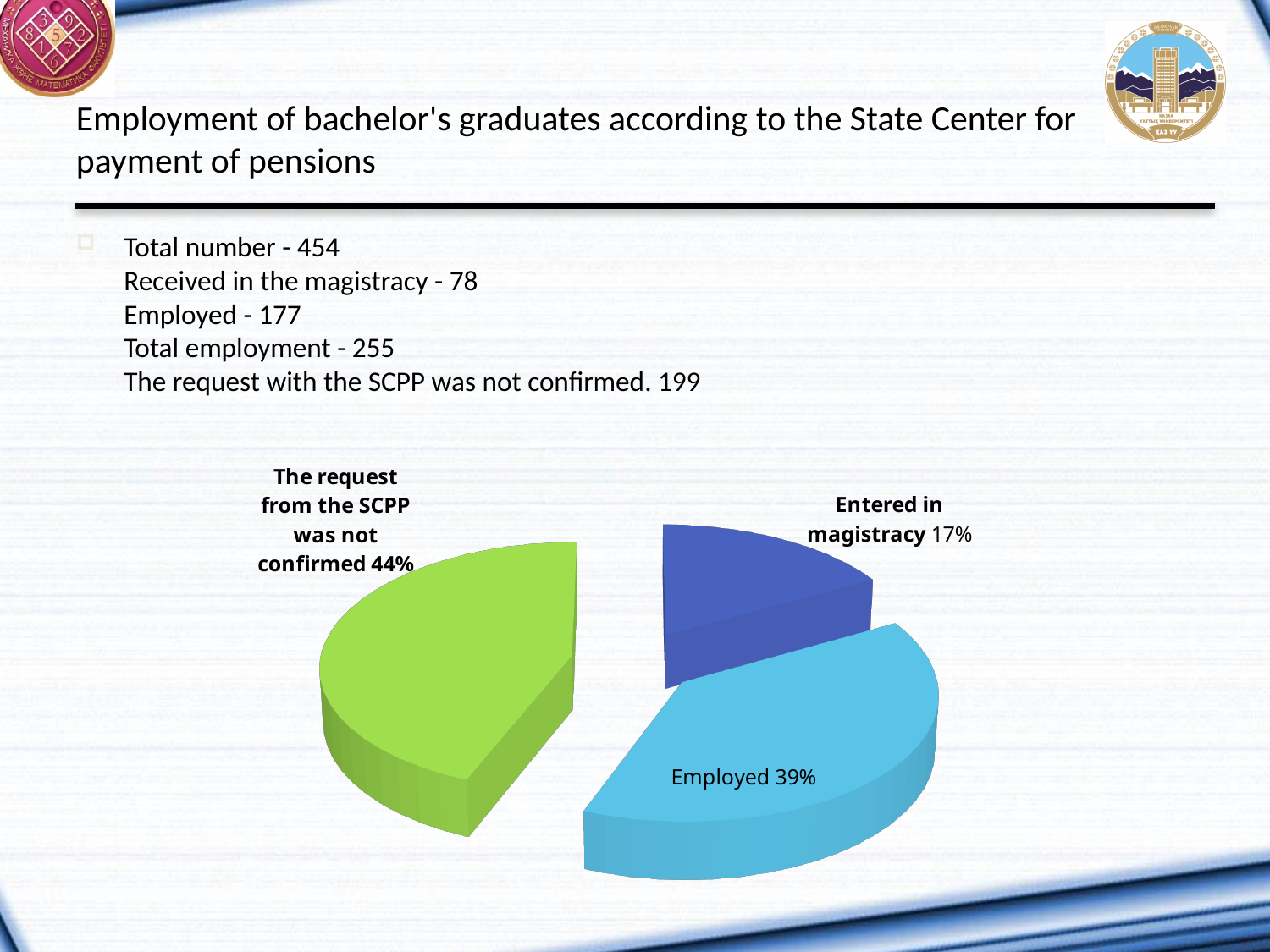
What share of the pie does the 'Employed' slice represent? 39% What colour is the 'The request from the SCPP was not confirmed' slice? green How many slices does the pie chart have? 3 What is the difference in percentage points between the 'The request from the SCPP was not confirmed' slice and the 'Employed' slice? 5 Which slice of the pie chart is the smallest? Entered in magistracy Which is larger: the 'Employed' slice or the 'Entered in magistracy' slice? Employed What is the difference in percentage points between the 'Employed' slice and the 'Entered in magistracy' slice? 22 What share of the pie does the 'The request from the SCPP was not confirmed' slice represent? 44% What kind of chart is shown on the slide? pie chart What colour is the 'Employed' slice of the pie chart? light blue What share of the pie does the 'Entered in magistracy' slice represent? 17% Which slice of the pie chart is the largest? The request from the SCPP was not confirmed